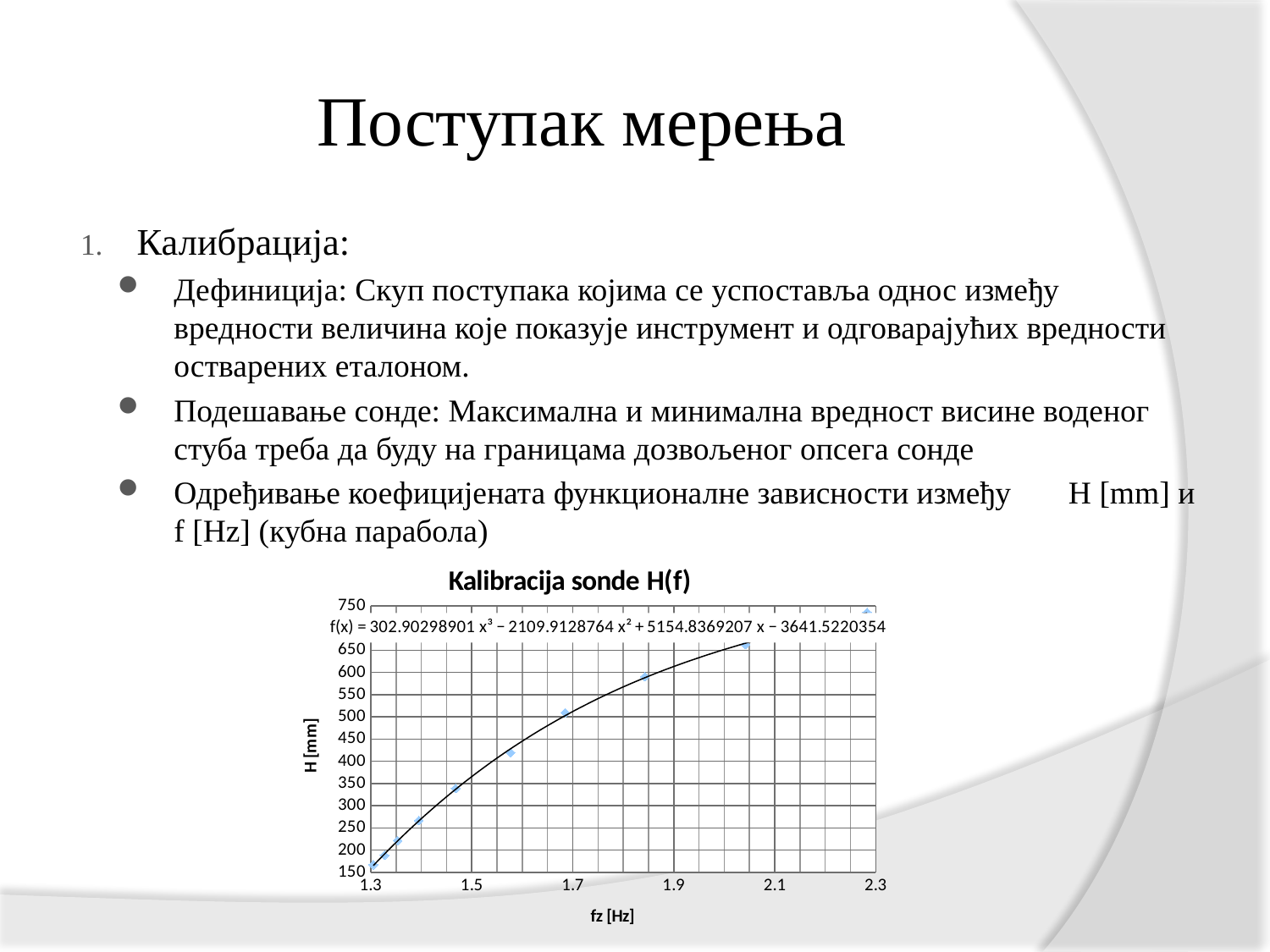
What kind of chart is shown on the slide? scatter chart What is the label of the vertical axis of the chart? H [mm] What is the coefficient of x³ in the fitted trendline equation shown on the chart? 302.90298901 Is the H value of the data point near fz = 1.7 Hz greater or less than 450? greater Is the H value of the data point near fz = 1.5 Hz greater or less than 300? greater What is the constant term in the fitted trendline equation shown on the chart? −3641.5220354 Is the H value of the lowest data point, near fz = 1.3 Hz, greater or less than 200? less What is the highest tick value shown on the vertical axis of the chart? 750 What is the lowest tick value shown on the horizontal axis of the chart? 1.3 What is the title of the chart? Kalibracija sonde H(f) Do the plotted H values rise or fall as fz increases along the x axis? rise